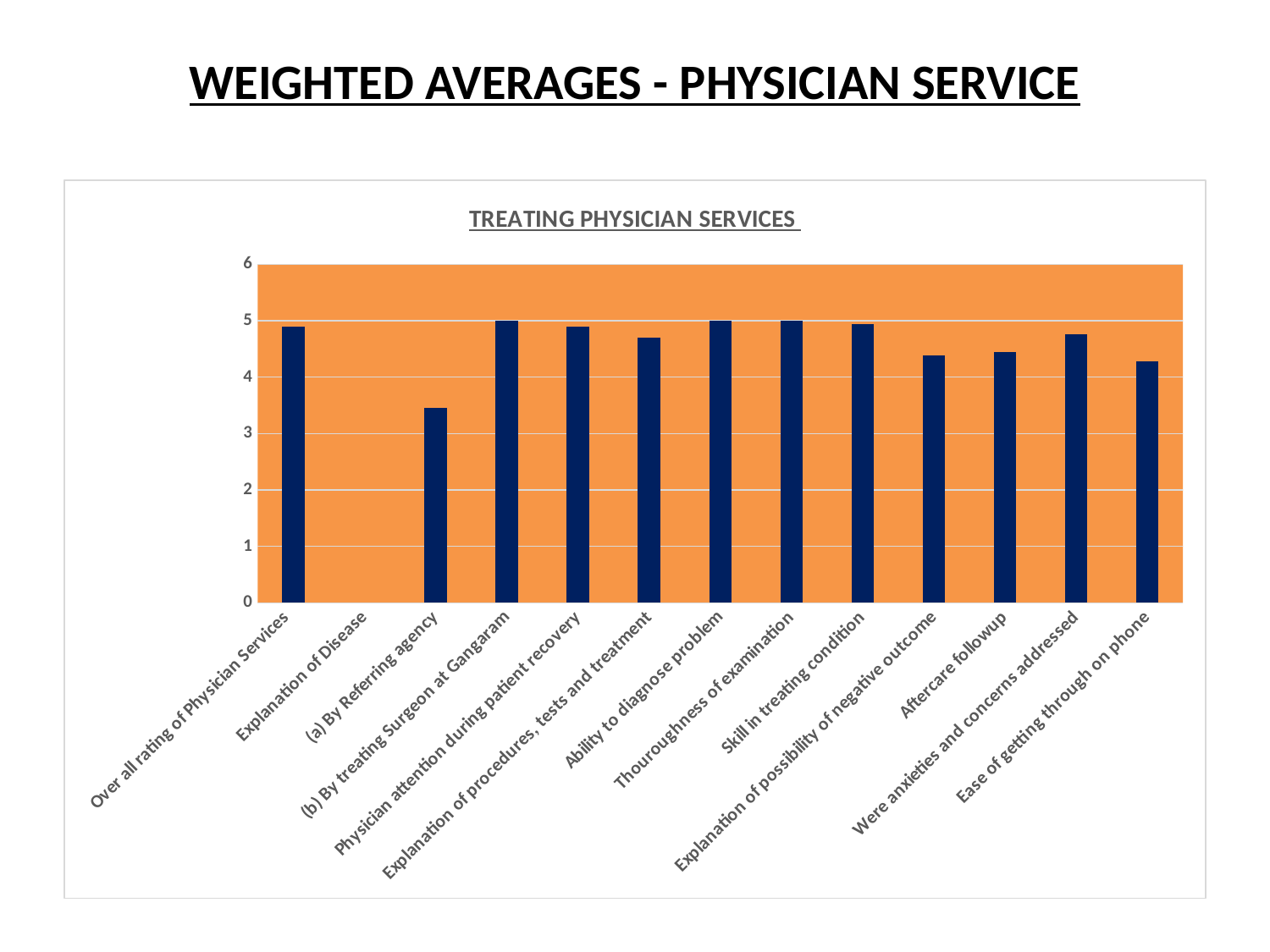
Is the value for Ease of getting through on phone greater or less than 4? greater Which category has the lowest value in the chart? (a) By Referring agency How many category labels are shown on the x axis of the chart? 13 Is the value for Explanation of possibility of negative outcome greater or less than 5? less What is the title of the chart? TREATING PHYSICIAN SERVICES Which is larger, the value for Ability to diagnose problem or the value for Explanation of possibility of negative outcome? Ability to diagnose problem What is the maximum value shown on the y axis of the chart? 6 Is the value for (a) By Referring agency greater or less than 4? less What kind of chart is shown on the slide? bar chart Which is larger, the value for (a) By Referring agency or the value for Ease of getting through on phone? Ease of getting through on phone